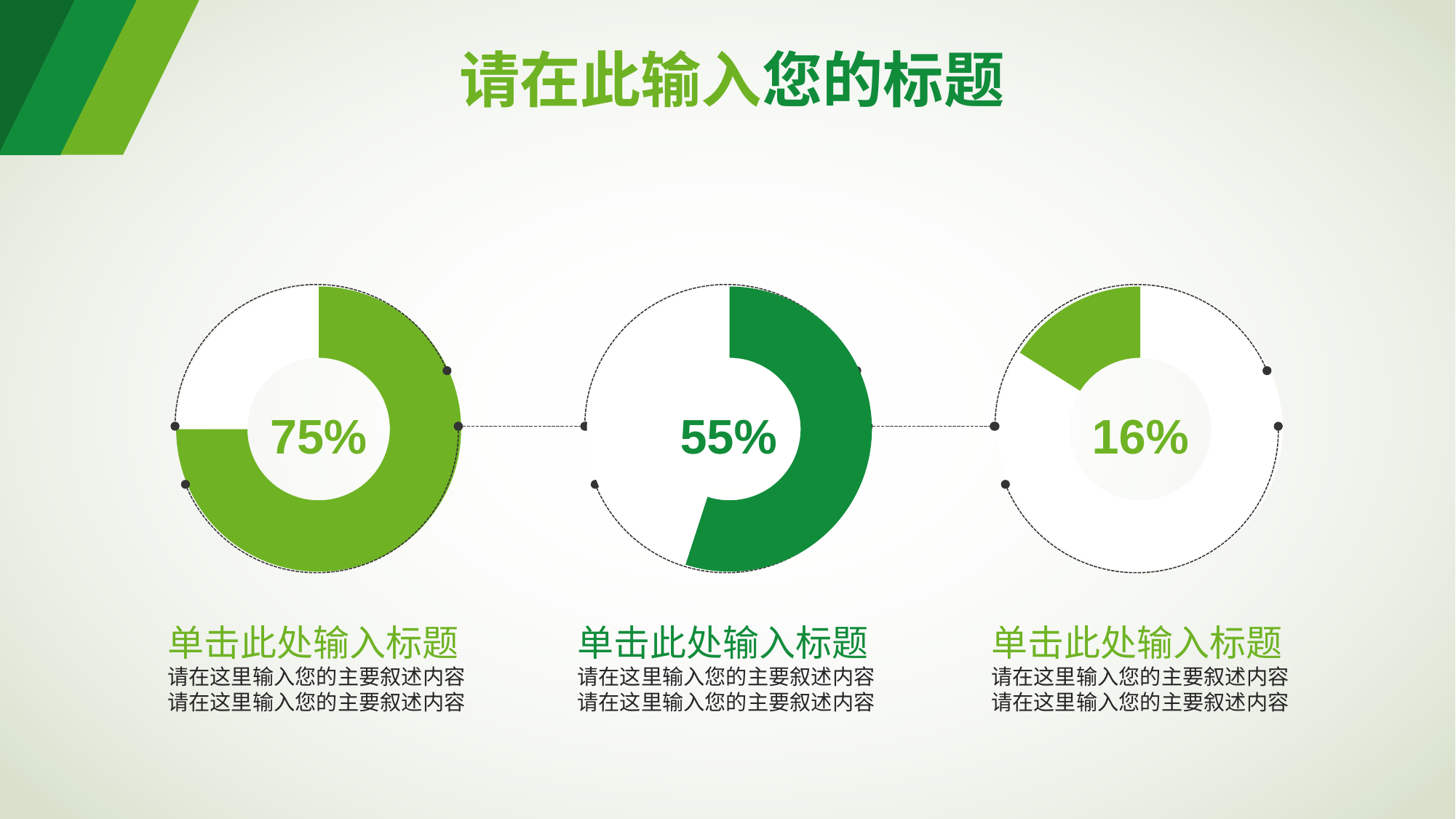
What kind of chart is used to display the percentages on this slide? donut chart Which of the three donut charts shows the highest percentage: left, middle or right? left What value is shown in the centre of the left donut chart? 75% Which of the three donut charts shows the lowest percentage: left, middle or right? right Which donut chart uses a darker green for its filled portion: left, middle or right? middle What is the difference between the percentage in the middle donut chart and the percentage in the right donut chart? 39% What value is shown in the centre of the right donut chart? 16% How many donut charts are shown on the slide? 3 What is the difference between the percentage in the left donut chart and the percentage in the middle donut chart? 20% Which is larger, the percentage in the middle donut chart or the percentage in the right donut chart? middle What value is shown in the centre of the middle donut chart? 55% Do the percentages rise or fall reading the donut charts from left to right? fall